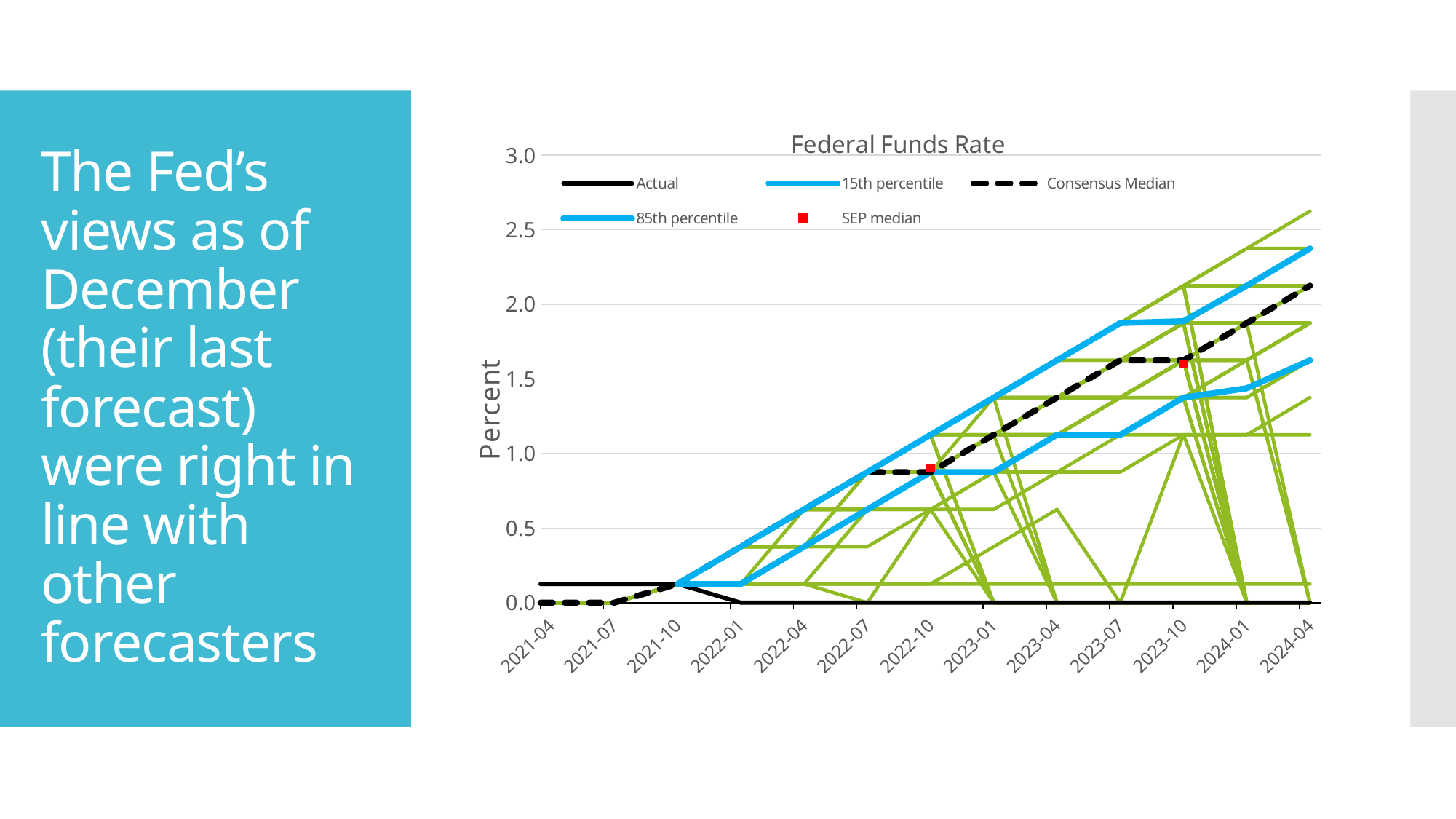
What is the title of the chart? Federal Funds Rate At 2024-04, which is higher: the 85th percentile line or the 15th percentile line? 85th percentile Is the value of the Actual line at 2022-01 greater or less than 0.5? less How many date labels are shown along the x axis? 13 What kind of chart is shown on the slide? line chart At 2024-04, which is higher: the Consensus Median line or the 15th percentile line? Consensus Median How many series does the chart legend list? 5 Is the value of the 85th percentile line at 2024-04 greater or less than 2.0? greater What is the label on the vertical axis of the chart? Percent Is the SEP median point at 2023-10 greater or less than 1.0? greater Does the 85th percentile line rise or fall from 2022-01 to 2024-04? rise